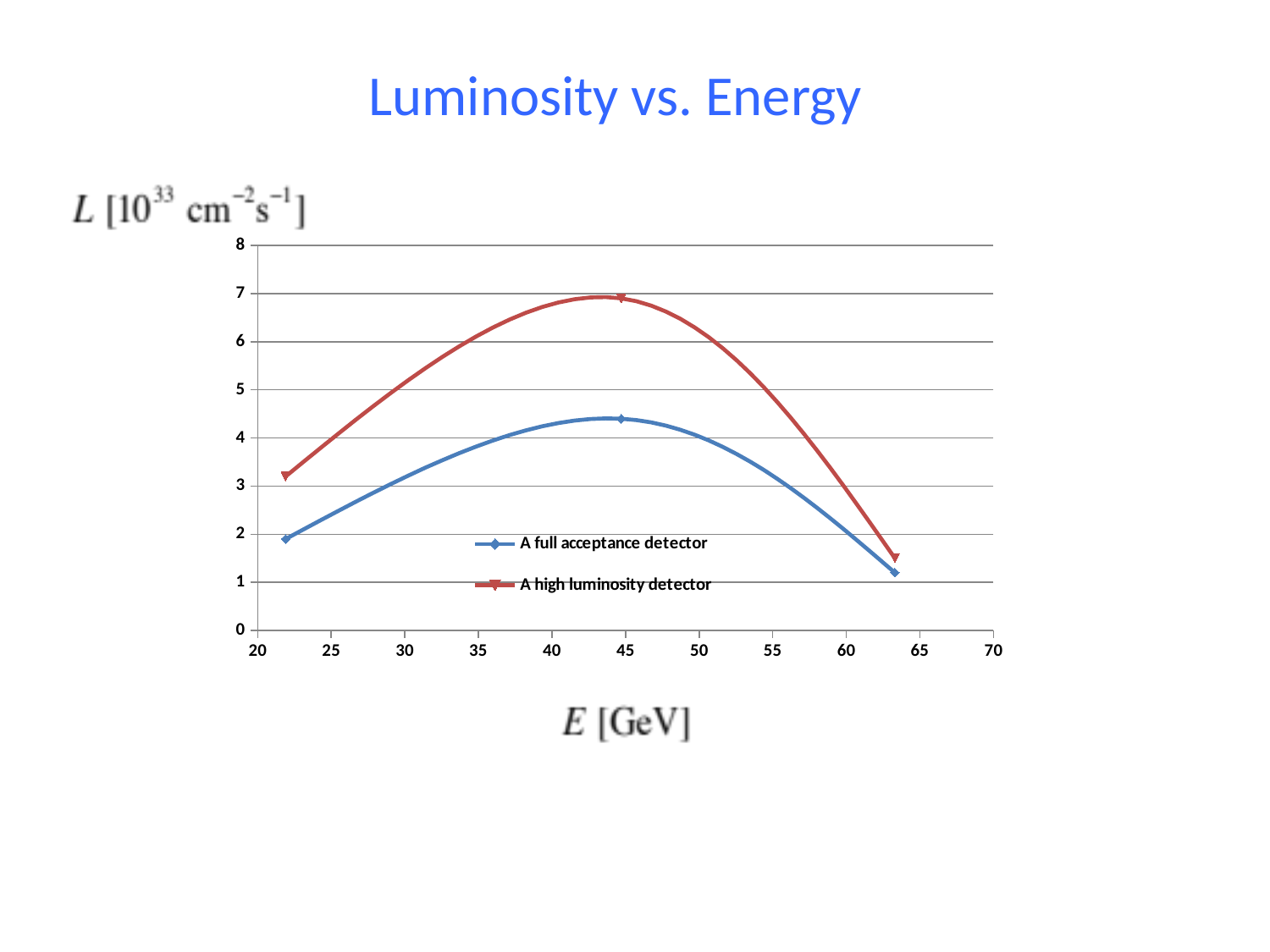
Is the peak value of the 'A full acceptance detector' series greater or less than 5? less Is the value of the 'A full acceptance detector' series at its highest-energy point (around 63 GeV) greater or less than 2? less Is the value of the 'A high luminosity detector' series at its highest-energy point (around 63 GeV) greater or less than 2? less What type of chart is shown on the slide? line chart Which series is drawn in red? A high luminosity detector At the middle data point (around 45 GeV), which series has the higher luminosity? A high luminosity detector How many series does the legend list? 2 How does the 'A high luminosity detector' series change as energy increases from 20 to 65 GeV? rises then falls How many data points are plotted for the 'A full acceptance detector' series? 3 What is the title of the slide's chart? Luminosity vs. Energy